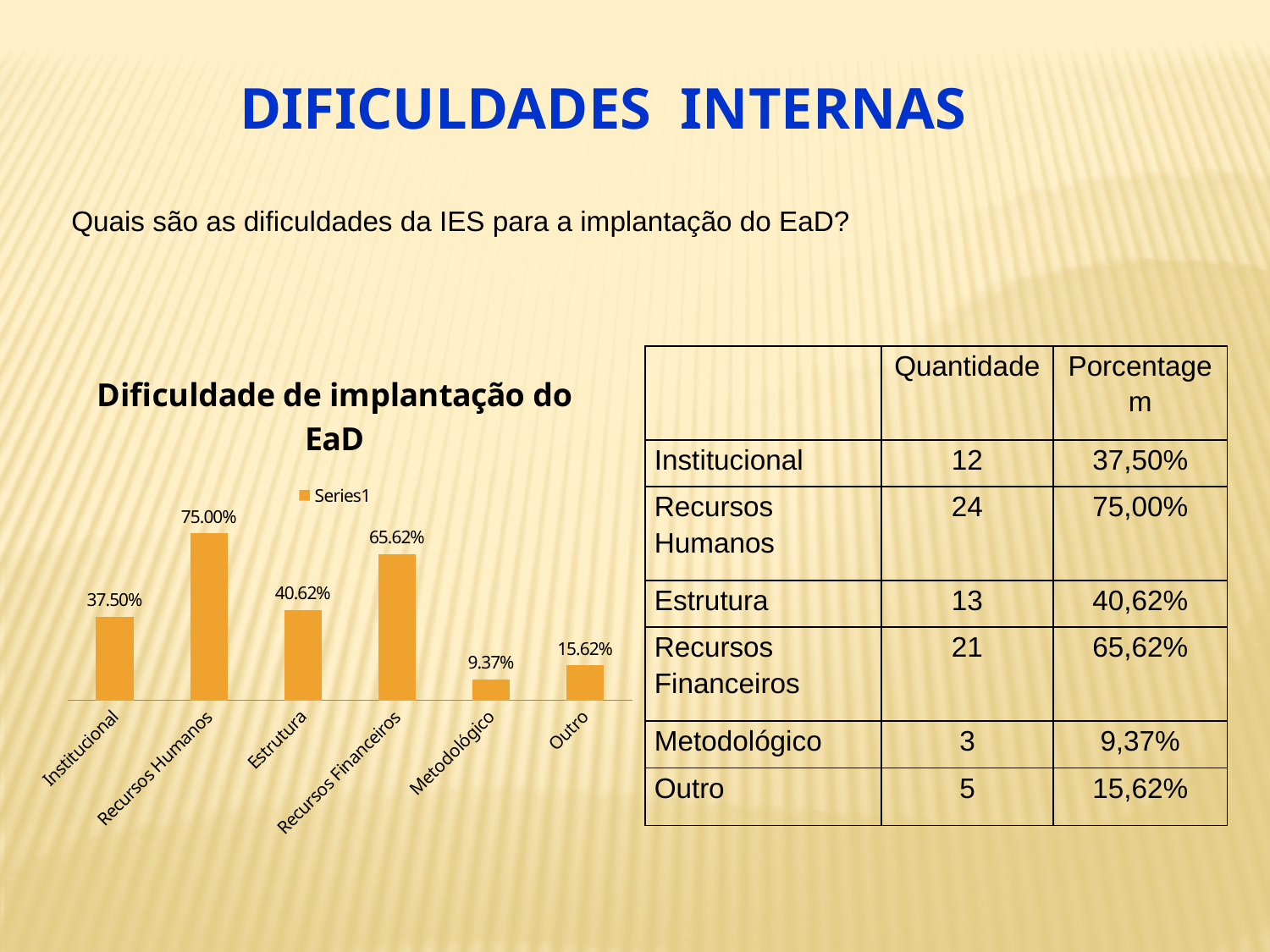
What is the value for Metodológico in the chart? 9.37% What is the difference between the values for Recursos Humanos and Recursos Financeiros? 9.38% Which is larger, the value for Estrutura or the value for Institucional? Estrutura What kind of chart is shown on the slide? Bar chart What is the difference between the values for Institucional and Metodológico? 28.13% What is the value for Outro in the chart? 15.62% How many categories are shown in the chart? 6 What is the title of the chart? Dificuldade de implantação do EaD Which category has the highest value in the chart? Recursos Humanos Which category has the lowest value in the chart? Metodológico What is the value for Recursos Humanos in the chart? 75.00% What is the value for Estrutura in the chart? 40.62%